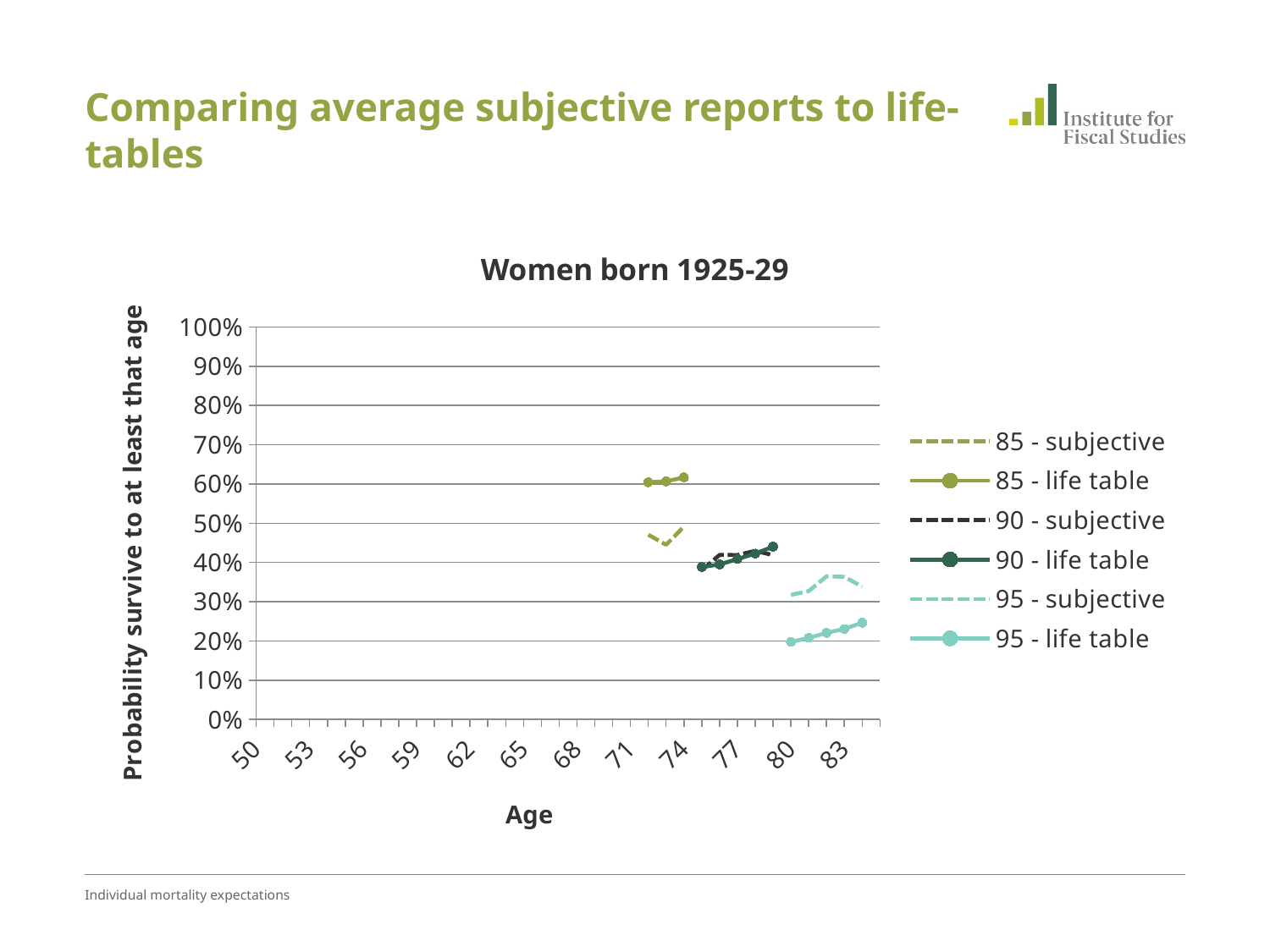
Which series is higher on the chart, '85 - life table' or '85 - subjective'? 85 - life table Are the values for the '90 - life table' series greater or less than 50%? less What is the label on the vertical axis of the chart? Probability survive to at least that age How many series does the legend list? 6 Do the values of the '95 - life table' series rise or fall as age increases? rise Are the values for the '85 - life table' series greater or less than 50%? greater What is the title of the chart? Women born 1925-29 Which series has the highest values on the chart? 85 - life table Which series is higher on the chart, '95 - subjective' or '95 - life table'? 95 - subjective What kind of chart is shown on the slide? line chart Are the values for the '95 - life table' series greater or less than 30%? less